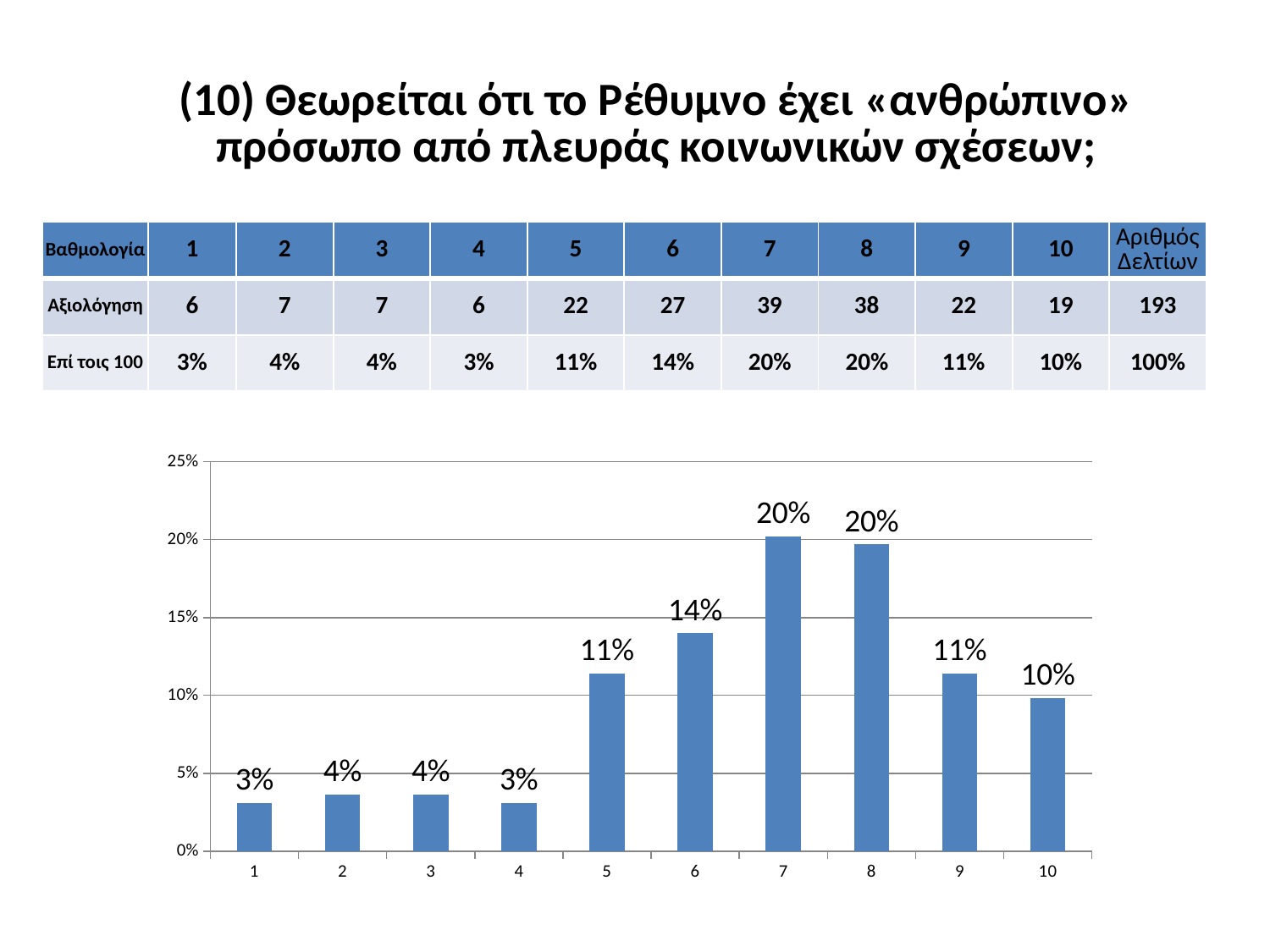
What is the value shown for category 6 in the chart? 14% How many categories are plotted along the x axis of the chart? 10 Which has a larger value, category 5 or category 6? 6 Is the value for category 8 greater or less than 15%? greater What is the difference between the values for category 6 and category 1? 11% Which has a larger value, category 9 or category 10? 9 Is the value for category 4 greater or less than 5%? less What type of chart is shown on the slide? bar chart What is the value shown for category 10 in the chart? 10% What is the value shown for category 2 in the chart? 4% What is the value shown for category 7 in the chart? 20% What is the difference between the values for category 7 and category 5? 9%